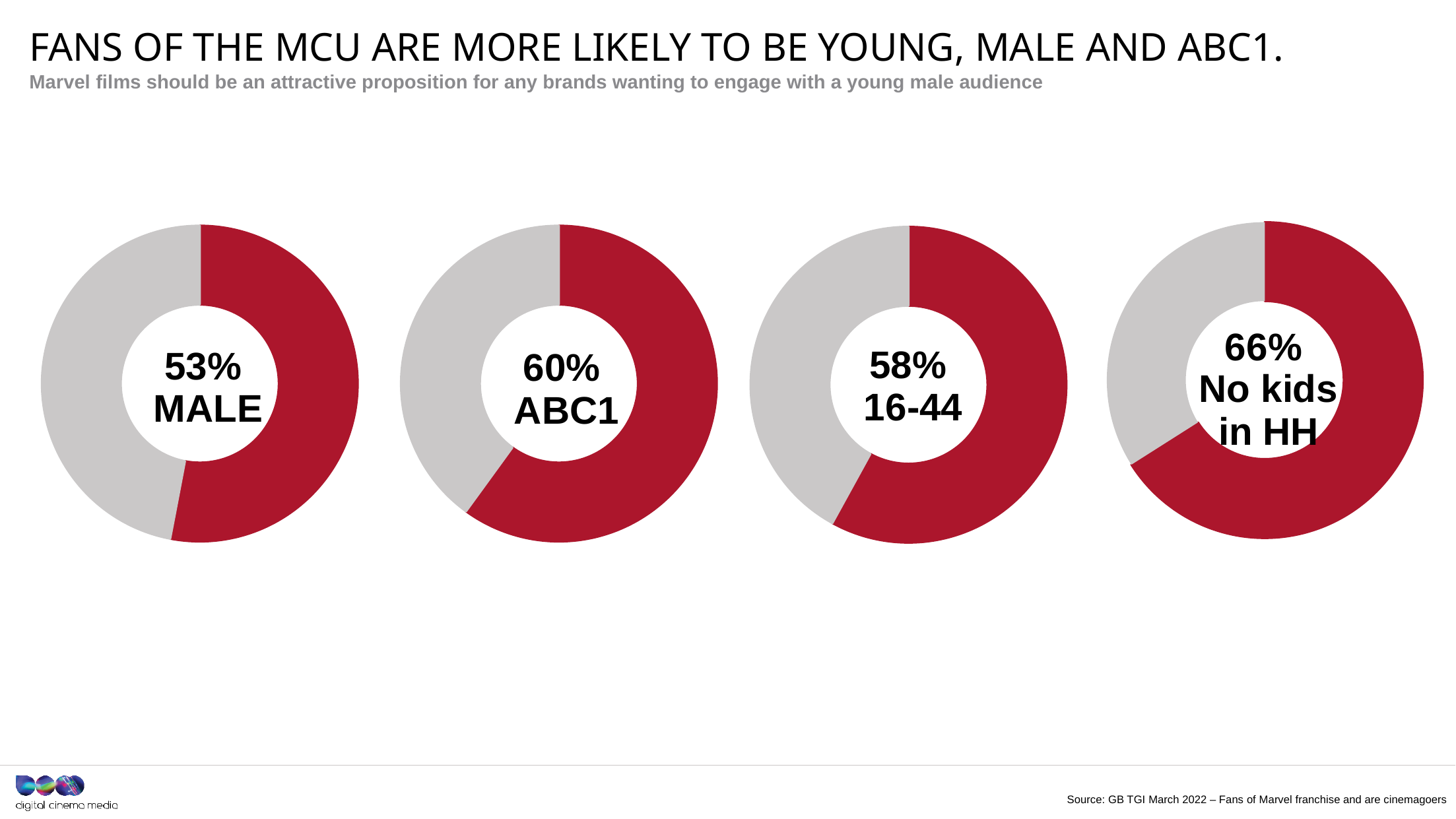
What percentage of MCU fans are aged 16-44, according to the third donut chart? 58% What percentage of MCU fans have no kids in the household, according to the fourth donut chart? 66% In the first donut chart, what share of the ring is grey (not male)? 47% Which of the four donut charts shows the highest percentage? No kids in HH (66%) What type of chart is used to show the MALE percentage? Donut (pie) chart How many donut charts are shown on the slide? 4 What percentage of MCU fans are male, according to the first donut chart? 53% What percentage of MCU fans are ABC1, according to the second donut chart? 60% What is the difference in percentage points between the ABC1 donut and the MALE donut? 7 percentage points What is the difference in percentage points between the No kids in HH donut and the 16-44 donut? 8 percentage points Which is larger: the ABC1 percentage or the 16-44 percentage? ABC1 (60%) Which of the four donut charts shows the lowest percentage? MALE (53%)